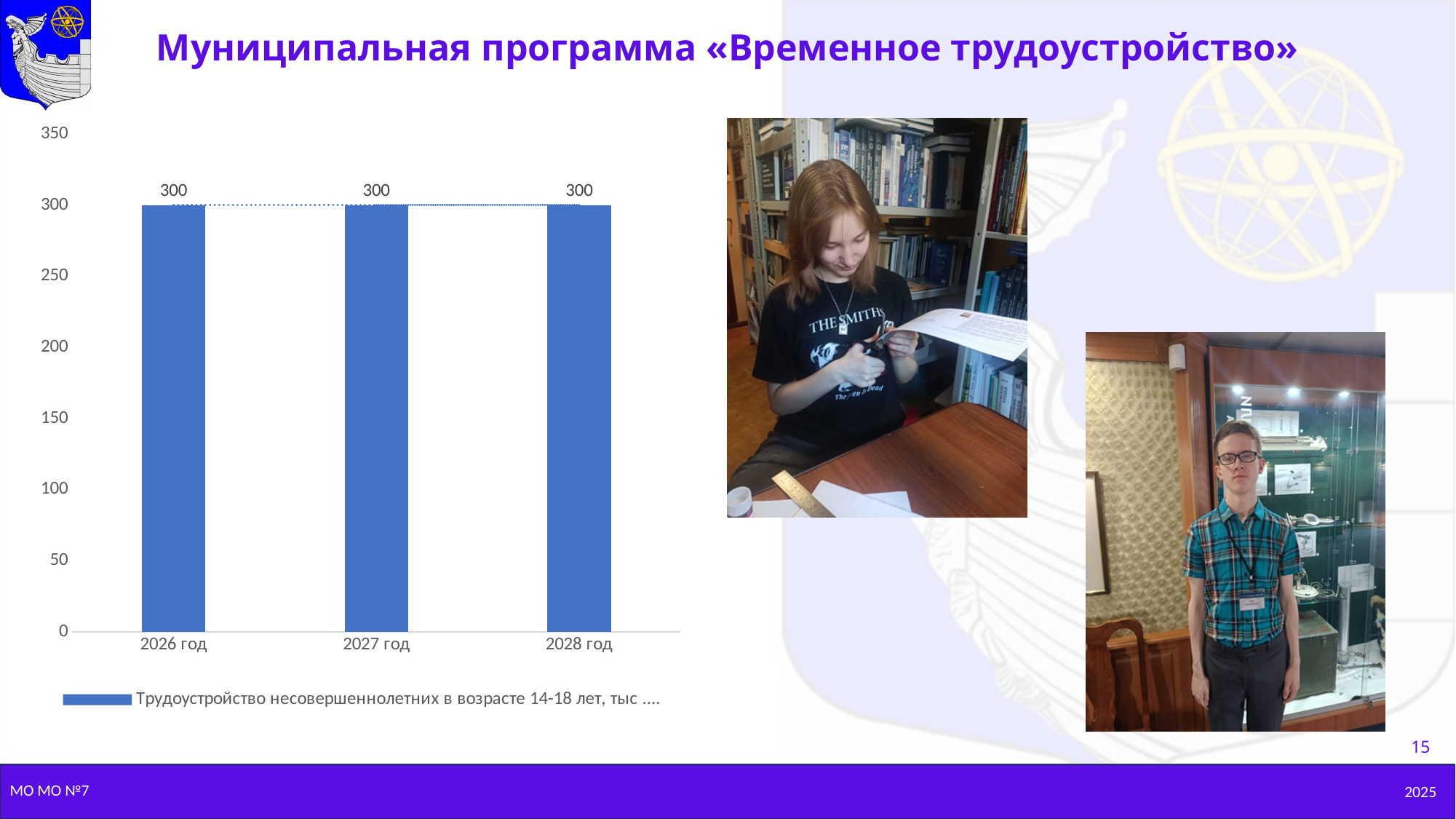
What kind of chart is shown on the slide? bar chart How many series does the legend list? 1 What is the difference between the values for 2028 год and 2026 год? 0 Is the value for 2026 год greater or less than 350? less What is the highest value shown on the vertical axis of the chart? 350 Is the value for 2027 год greater or less than 250? greater What is the value for 2027 год? 300 How many categories are shown on the x axis of the chart? 3 What is the value for 2028 год? 300 What is the value for 2026 год? 300 Do the values rise, fall or stay the same from 2026 год to 2028 год? stay the same What age range is mentioned in the chart's legend entry? 14-18 лет